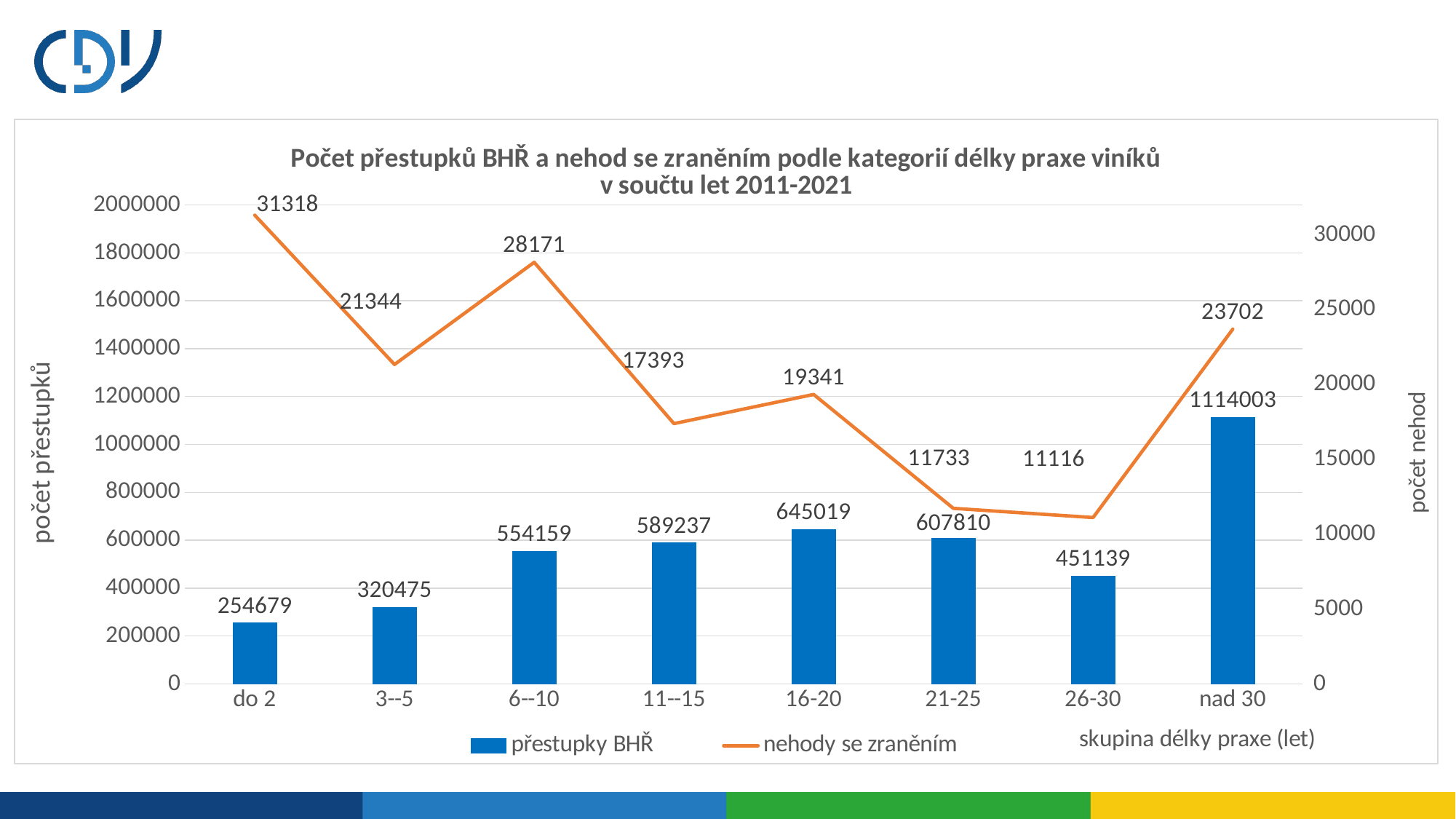
What is the label of the left vertical axis? počet přestupků Which is larger, the přestupky BHŘ value for '21-25' or for '26-30'? 21-25 How many series does the legend list? 2 Which category has the lowest value of přestupky BHŘ? do 2 How many categories of délka praxe are shown on the x axis? 8 What is the value of přestupky BHŘ for the category '16-20'? 645019 What kind of chart is used for the series 'nehody se zraněním'? line chart Which category has the highest value of nehody se zraněním? do 2 What is the value of přestupky BHŘ for the category 'nad 30'? 1114003 What is the value of nehody se zraněním for the category 'do 2'? 31318 Which category has the lowest value of nehody se zraněním? 26-30 What is the difference between the nehody se zraněním values for '6--10' and '3--5'? 6827